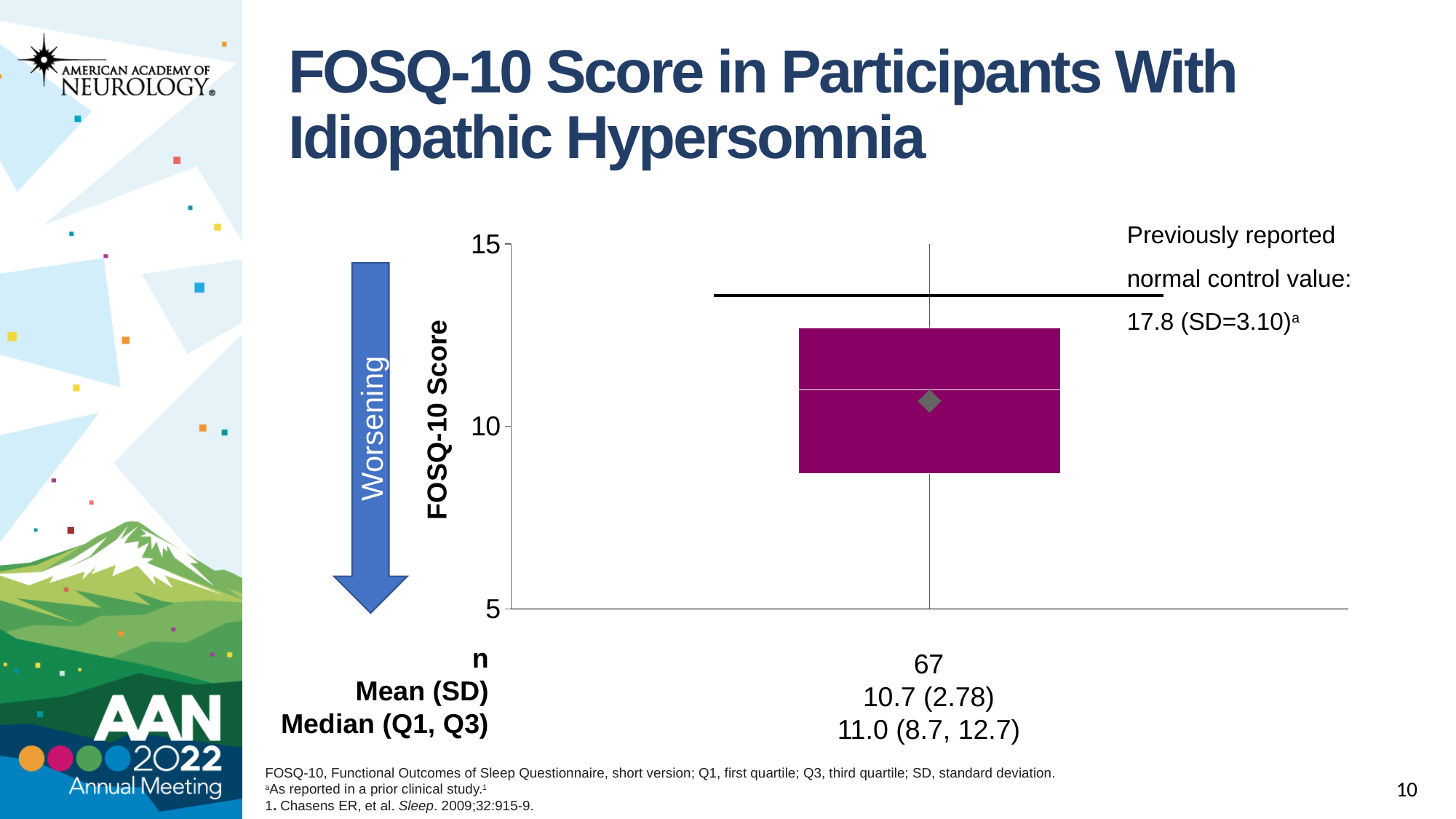
Which is larger: the mean FOSQ-10 score in participants or the previously reported normal control value? the previously reported normal control value What word is written on the blue downward arrow next to the chart? Worsening What is the previously reported normal control value stated on the slide? 17.8 (SD=3.10) Is the median FOSQ-10 score greater or less than 15? less What is the number of participants (n) shown below the chart? 67 What is the mean (SD) FOSQ-10 score shown below the chart? 10.7 (2.78) What is the difference between the previously reported normal control value (17.8) and the mean FOSQ-10 score (10.7)? 7.1 What is the label of the vertical axis of the chart? FOSQ-10 Score What are the Q1 and Q3 values of the FOSQ-10 score shown below the chart? 8.7, 12.7 What kind of chart is shown on the slide? box plot What is the difference between Q3 (12.7) and Q1 (8.7) of the FOSQ-10 score? 4.0 What is the median FOSQ-10 score shown below the chart? 11.0